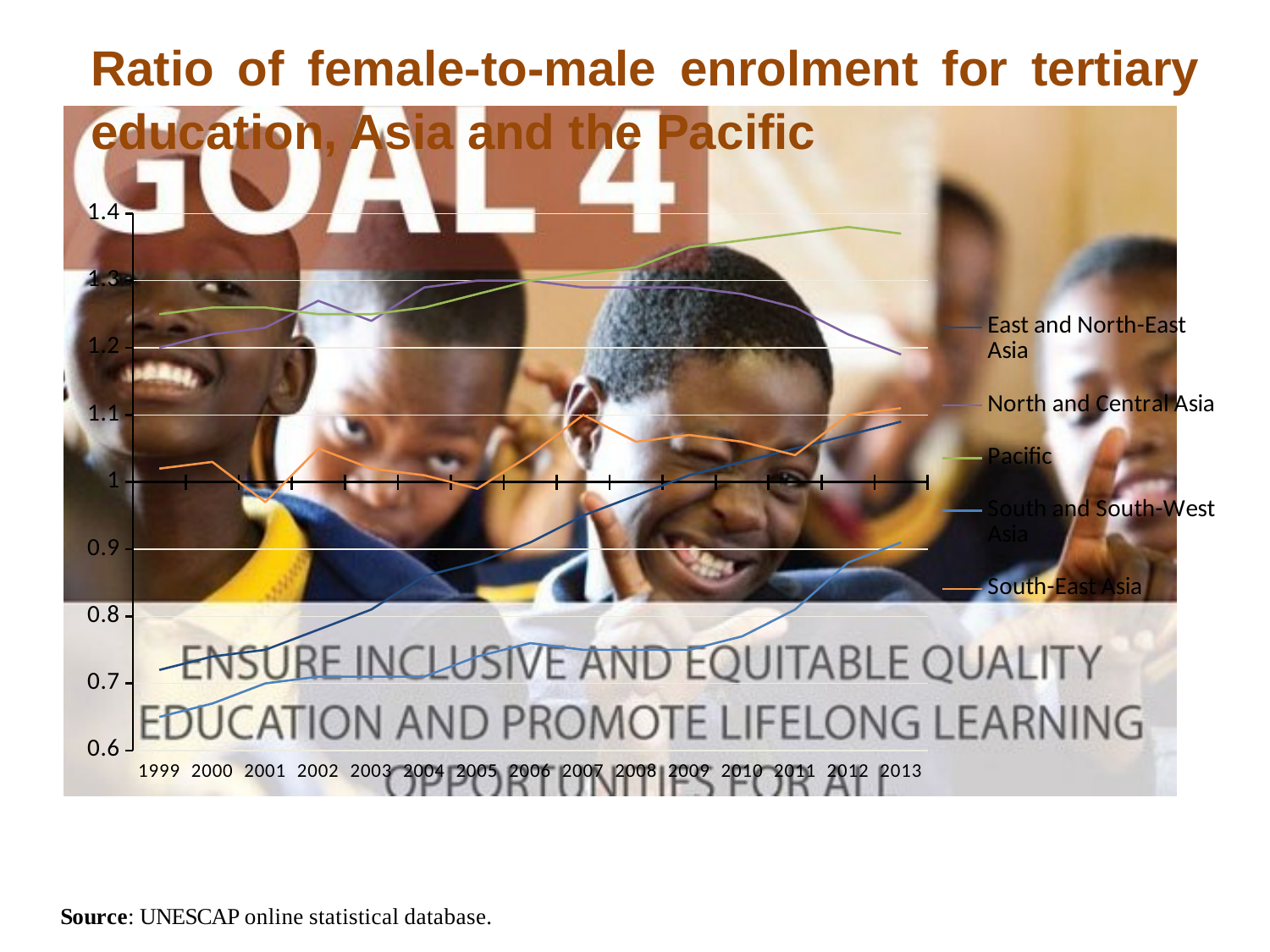
Is the value for South and South-West Asia in 1999 greater or less than 0.7? less Is the value for East and North-East Asia in 2013 greater or less than 1? greater In 1999, which is larger: the ratio for South-East Asia or for East and North-East Asia? South-East Asia Is the value for Pacific in 2013 greater or less than 1.3? greater How many years are shown on the x axis? 15 What kind of chart is shown on the slide? line chart Which region has the lowest ratio in 1999? South and South-West Asia Which region has the lowest ratio in 2013? South and South-West Asia Which region has the highest ratio in 2013? Pacific Does the ratio for South and South-West Asia rise or fall from 1999 to 2013? rise How many series does the legend list? 5 What is the source cited for the chart data? UNESCAP online statistical database